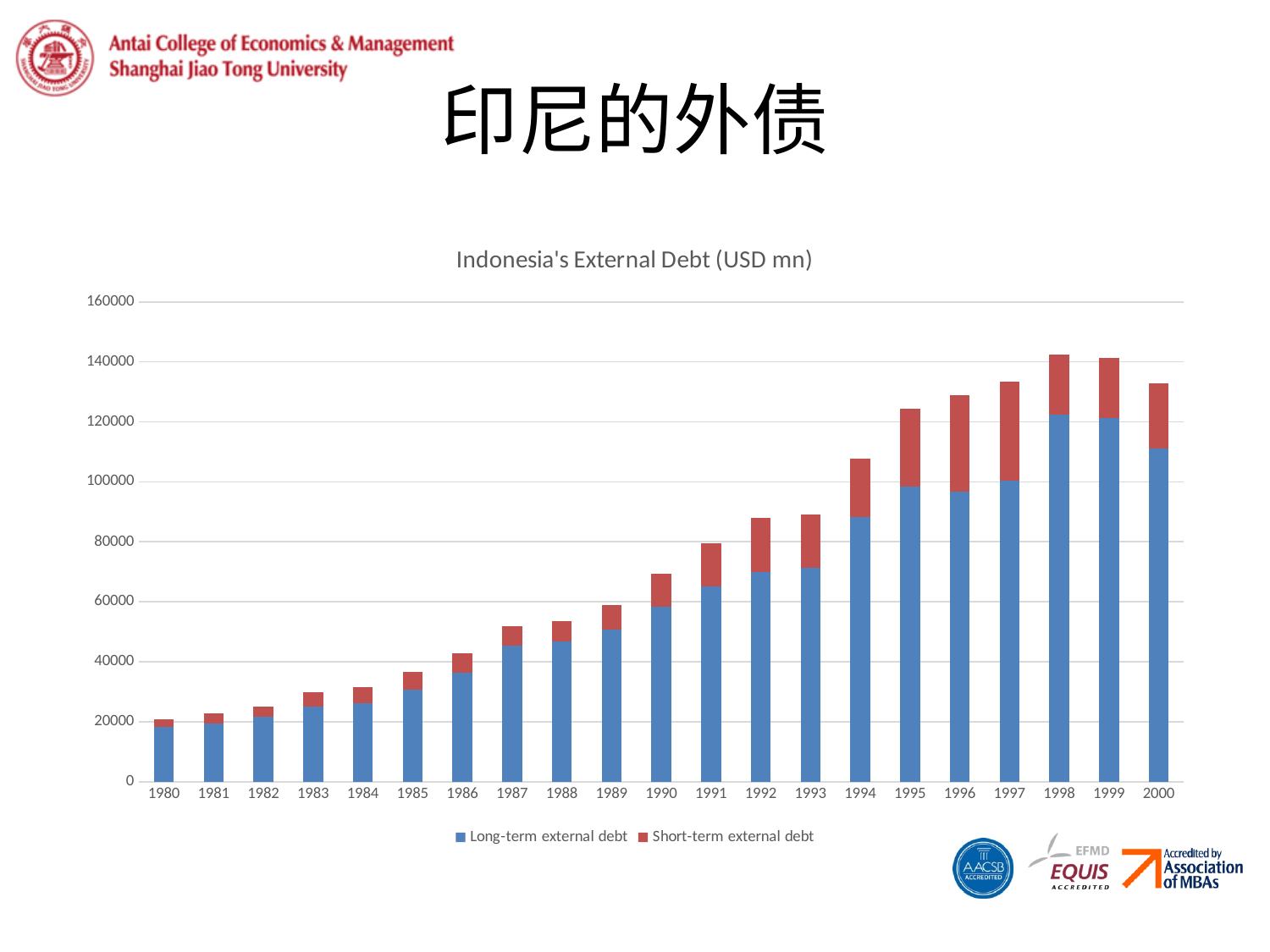
Which series is shown in red? Short-term external debt Which year has the larger total external debt, 1993 or 1995? 1995 What is the title of the chart? Indonesia's External Debt (USD mn) Is the total external debt for 1994 greater or less than 100000? greater Is the total external debt for 1993 greater or less than 100000? less Is the total external debt for 2000 greater or less than 120000? greater What type of chart is shown on the slide? Stacked bar chart Which year has the lowest total external debt? 1980 How many years are shown on the x axis? 21 Does total external debt generally rise or fall from 1980 to 1998? rise How many series does the legend list? 2